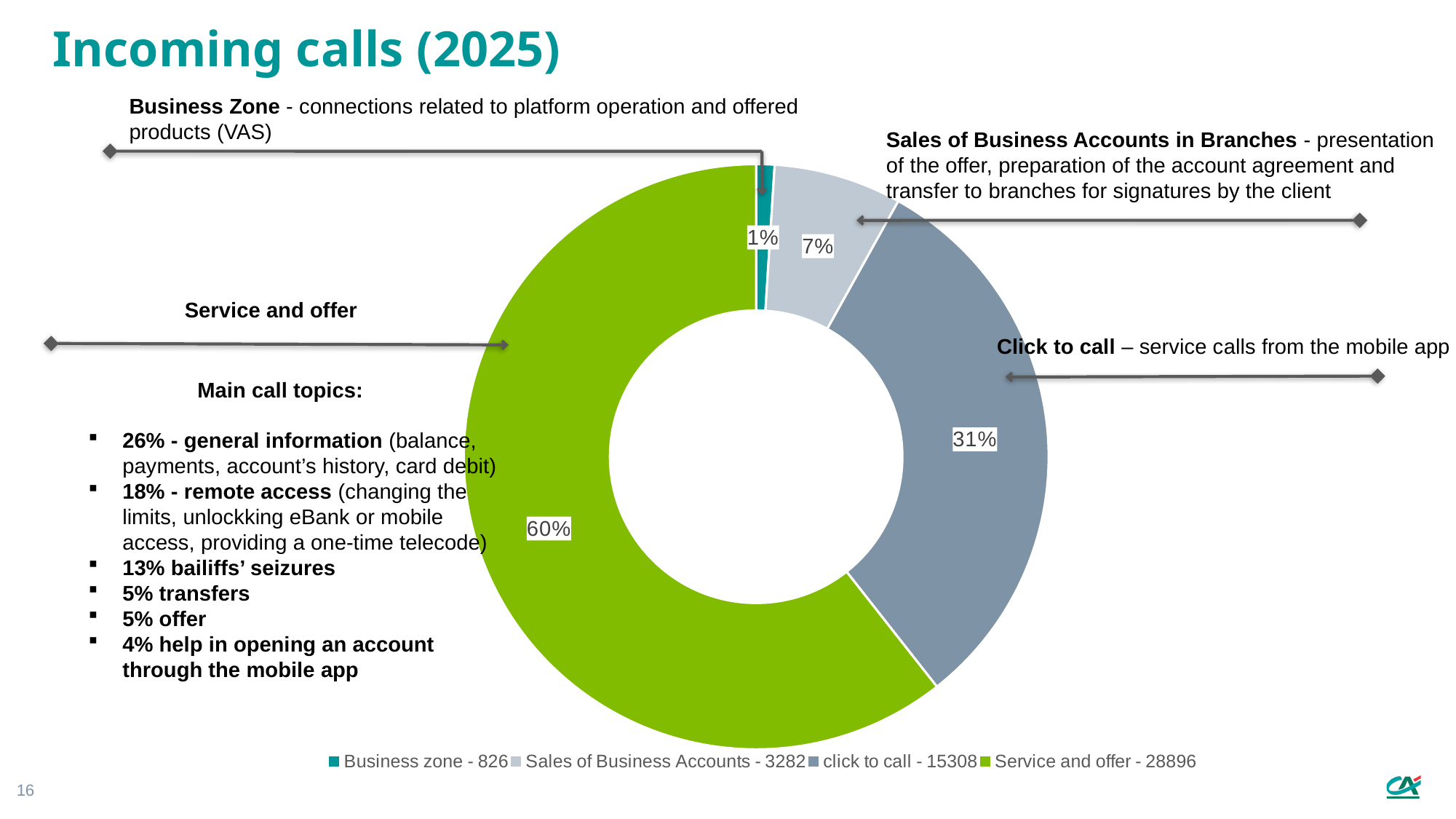
Which category has the smallest share of incoming calls? Business zone What percentage share does the Service and offer slice have? 60% Which category has the largest share of incoming calls? Service and offer What kind of chart is shown on the slide? Pie chart (donut) What percentage share does the Sales of Business Accounts slice have? 7% What percentage share does the click to call slice have? 31% Which is larger, the click to call share or the Sales of Business Accounts share? click to call How many categories does the chart show? 4 According to the legend, how many calls does the click to call category represent? 15308 What is the difference in percentage points between the Service and offer share and the click to call share? 29 percentage points What colour is the Service and offer slice? Green